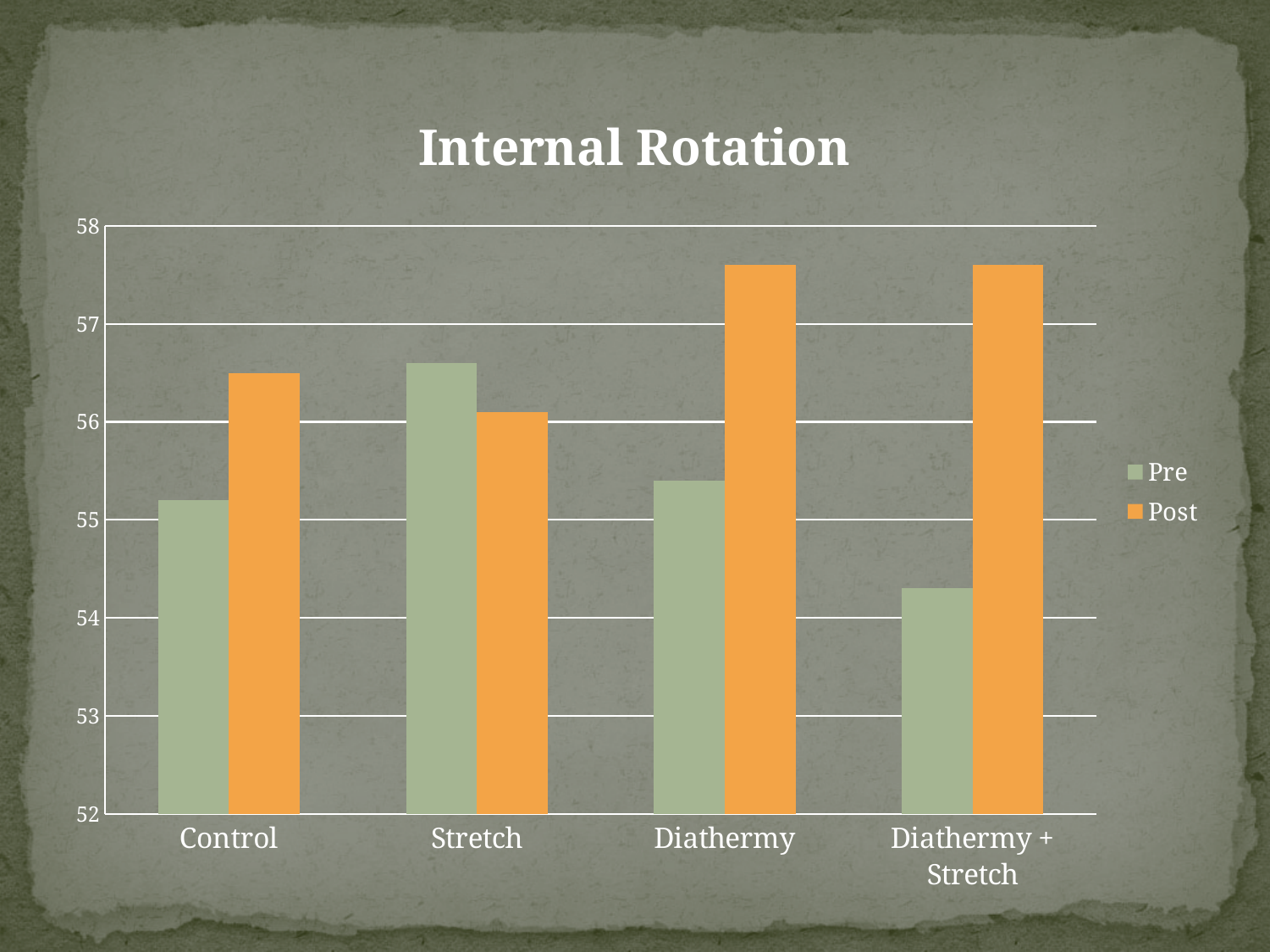
Is the Pre value for Control greater or less than 56? less Which category has the lowest Post value? Stretch How many series does the legend list? 2 How many categories are shown on the x axis? 4 Which category has the highest Pre value? Stretch Which category has the lowest Pre value? Diathermy + Stretch For Stretch, which is larger, the Pre value or the Post value? Pre What is the title of the chart? Internal Rotation What kind of chart is shown on the slide? bar chart Is the Pre value for Diathermy + Stretch greater or less than 55? less For Control, which is larger, the Pre value or the Post value? Post Is the Post value for Diathermy greater or less than 57? greater